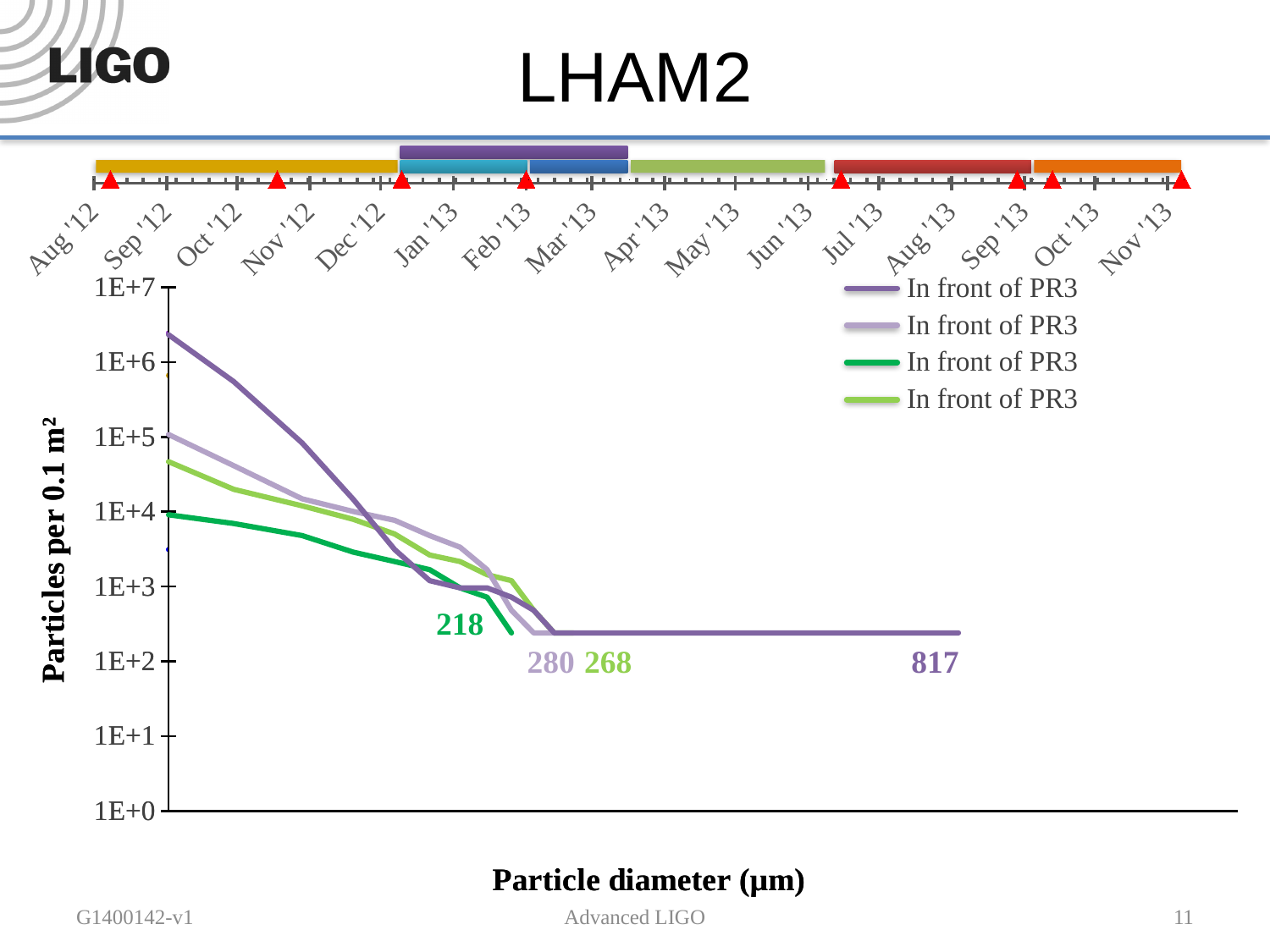
Is the starting value of the dark purple line at the left of the chart greater or less than 1E+6? greater Do the plotted values rise or fall as particle diameter increases along the x axis? fall What is the label on the x axis of the chart? Particle diameter (µm) What number is printed at the end of the dark purple line? 817 What number is printed at the end of the light purple line? 280 Which is larger, the number printed at the end of the light purple line or the number printed at the end of the light green line? light purple line (280) Which line has the largest printed end-point number? dark purple line (817) What number is printed at the end of the dark green line? 218 What is the label on the y axis of the chart? Particles per 0.1 m² How many series does the legend list? 4 What number is printed at the end of the light green line? 268 What kind of chart is shown on the slide? line chart